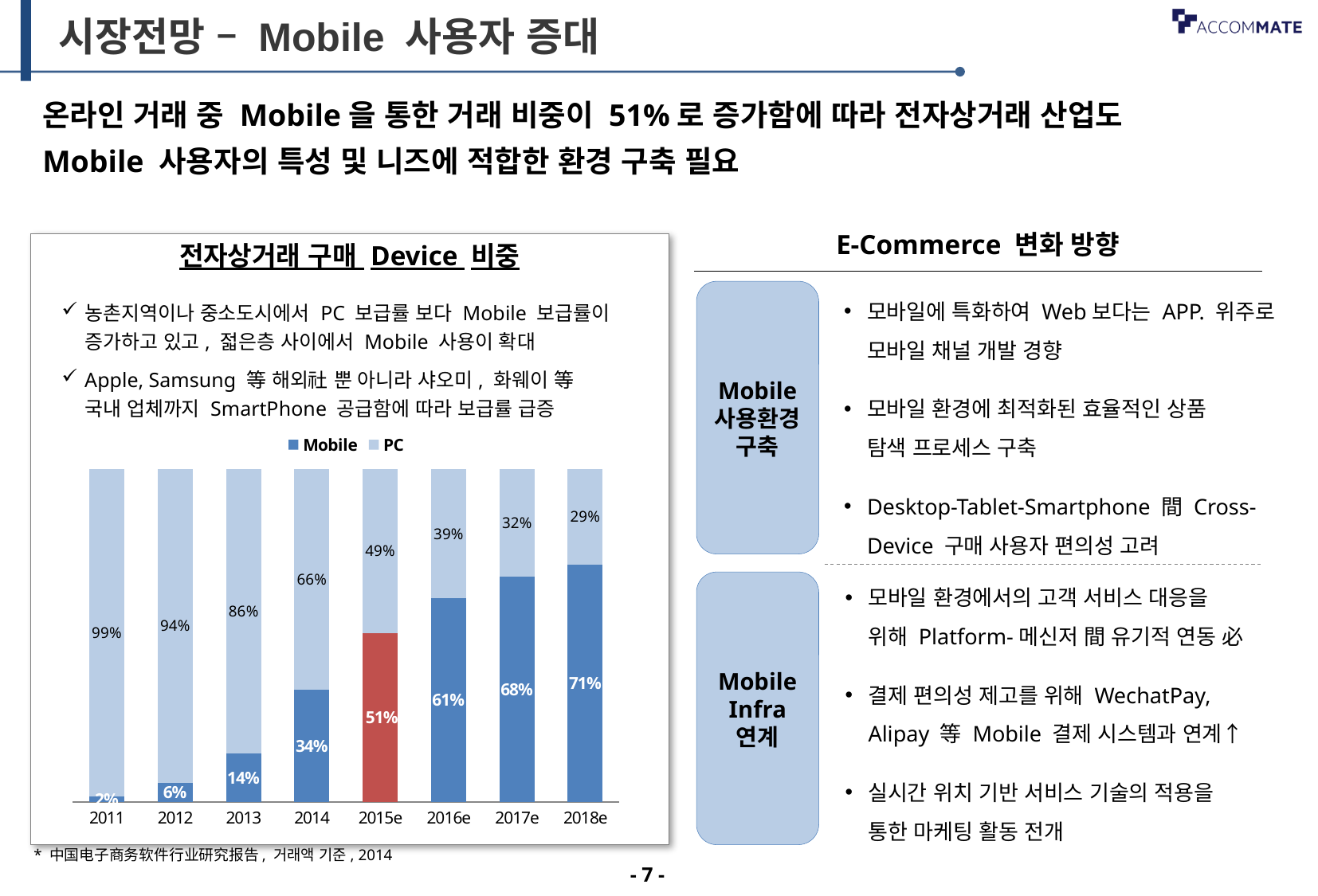
What is the Mobile share for 2018e? 71% What kind of chart is shown on the slide? Stacked bar chart What is the PC share for 2016e? 39% What is the difference between the Mobile share in 2017e and in 2014? 34% Which is larger in 2014, the Mobile share or the PC share? PC How many years are shown on the x axis of the chart? 8 Does the Mobile share rise or fall from 2011 to 2018e? Rise What is the PC share for 2013? 86% How many series does the chart legend list? 2 What is the Mobile share for 2015e? 51% Which year has the lowest PC share? 2018e Which year has the highest Mobile share? 2018e